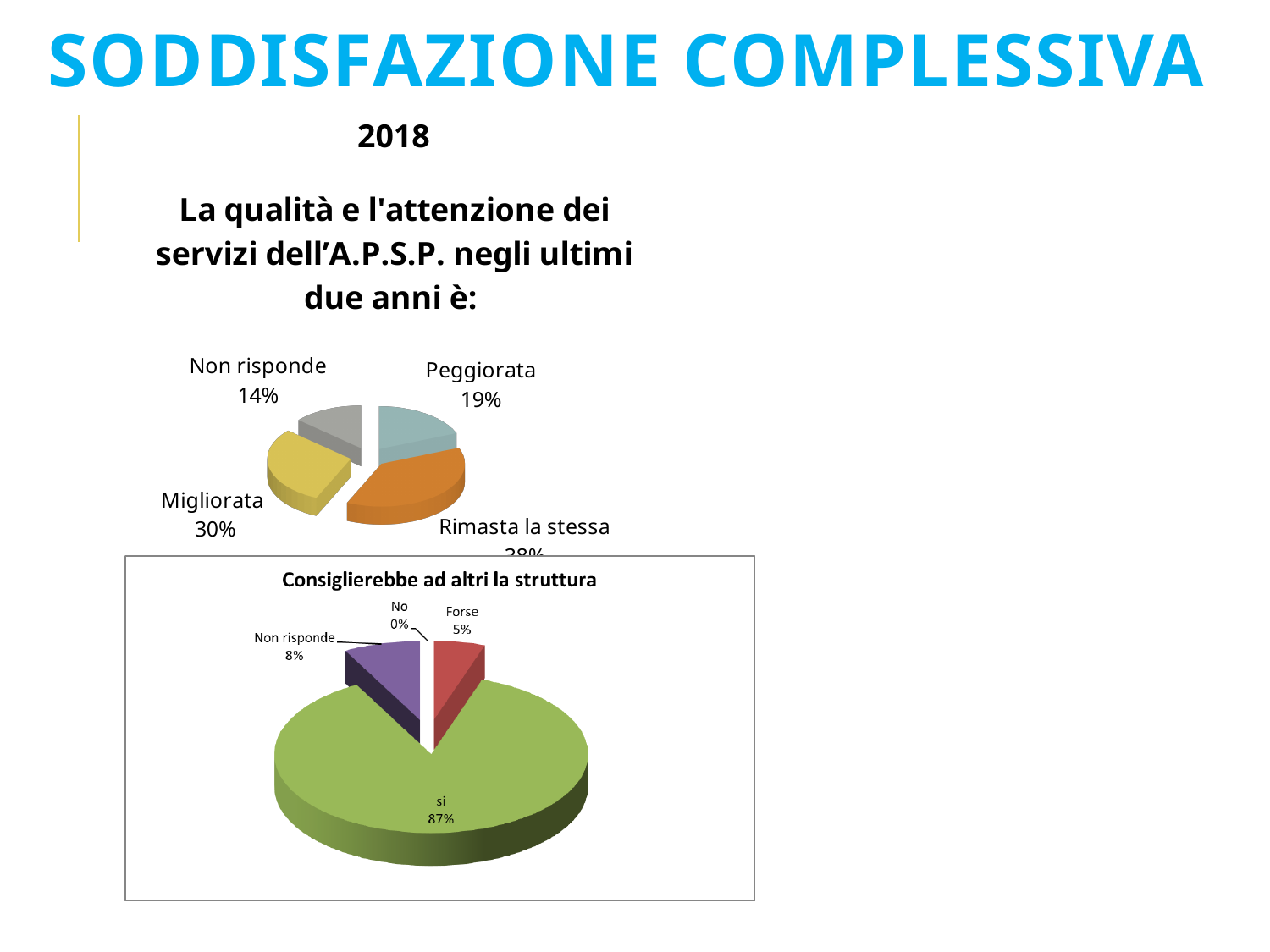
In the bottom chart 'Consiglierebbe ad altri la struttura', what percentage answered sì? 87% In the bottom chart 'Consiglierebbe ad altri la struttura', what is the difference between Non risponde and Forse? 3% In the top chart (quality of A.P.S.P. services in the last two years), what percentage is shown for Non risponde? 14% In the top chart (quality of A.P.S.P. services in the last two years), what percentage is shown for Peggiorata? 19% In the top chart (quality of A.P.S.P. services in the last two years), which is larger: Migliorata or Non risponde? Migliorata In the top chart (quality of A.P.S.P. services in the last two years), which category has the smallest share? Non risponde In the top chart (quality of A.P.S.P. services in the last two years), how many percentage points larger is Migliorata than Peggiorata? 11% In the bottom chart 'Consiglierebbe ad altri la struttura', what percentage answered Forse? 5% In the bottom chart 'Consiglierebbe ad altri la struttura', which answer has the largest share? sì How many categories are shown in the bottom chart 'Consiglierebbe ad altri la struttura'? 4 In the top chart (quality of A.P.S.P. services in the last two years), what percentage is shown for Migliorata? 30% What kind of chart is the top chart about the quality and attention of the A.P.S.P. services? Pie chart